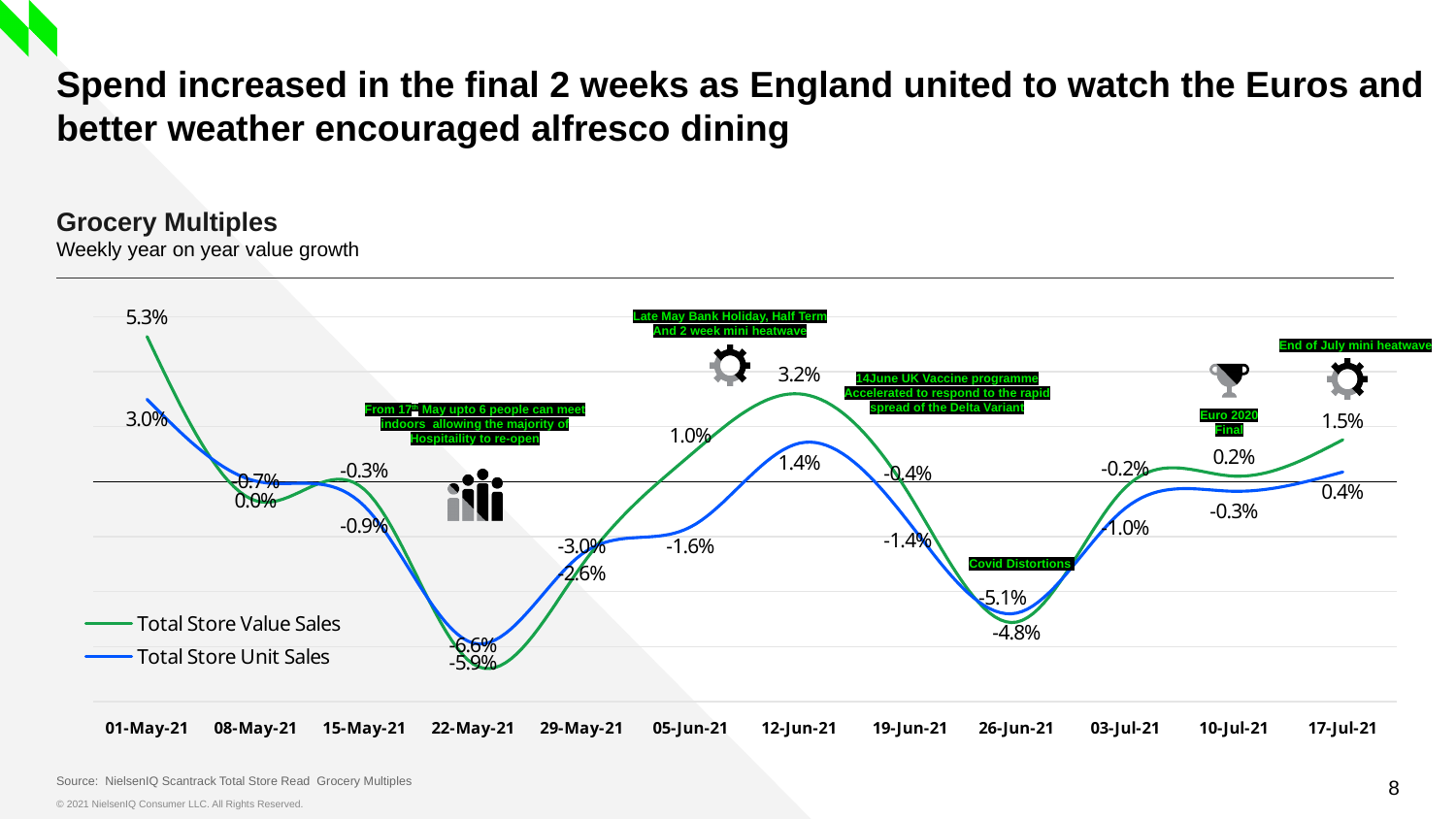
Does Total Store Value Sales growth rise or fall from 26-Jun-21 to 17-Jul-21? Rise How many weekly dates are shown on the x axis? 12 What is the Total Store Unit Sales growth for 03-Jul-21? -1.0% What is the Total Store Value Sales growth for 01-May-21? 5.3% What kind of chart is shown on the slide? Line chart What is the Total Store Value Sales growth for 12-Jun-21? 3.2% On which date is Total Store Value Sales growth highest? 01-May-21 How many series does the legend list? 2 What is the Total Store Unit Sales growth for 17-Jul-21? 0.4% On 05-Jun-21, which series has the higher growth, Total Store Value Sales or Total Store Unit Sales? Total Store Value Sales On which date is Total Store Value Sales growth lowest? 22-May-21 What is the difference between Total Store Value Sales and Total Store Unit Sales growth on 12-Jun-21? 1.8 percentage points